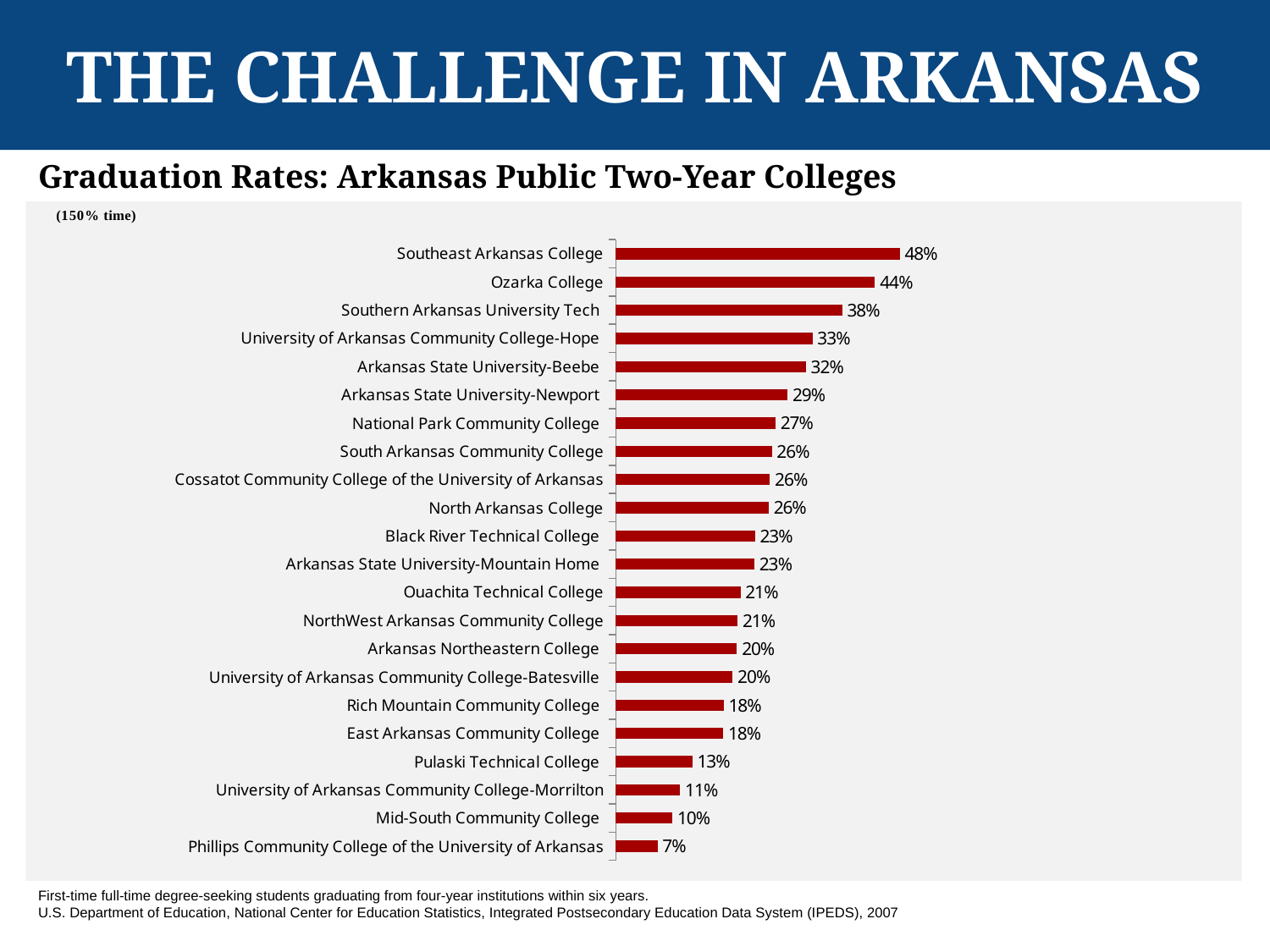
What is the graduation rate for Southeast Arkansas College? 48% Which college has the highest graduation rate? Southeast Arkansas College What type of chart is used to show the graduation rates? Bar chart How many colleges are shown in the chart? 22 What is the difference in graduation rate between Ozarka College and Mid-South Community College? 34% Which has a higher graduation rate, Arkansas State University-Newport or Black River Technical College? Arkansas State University-Newport Which has a higher graduation rate, University of Arkansas Community College-Morrilton or Rich Mountain Community College? Rich Mountain Community College What is the graduation rate for Pulaski Technical College? 13% What is the difference in graduation rate between Southern Arkansas University Tech and Arkansas State University-Beebe? 6% What is the graduation rate for National Park Community College? 27% What is the title of the chart? Graduation Rates: Arkansas Public Two-Year Colleges Which college has the lowest graduation rate? Phillips Community College of the University of Arkansas